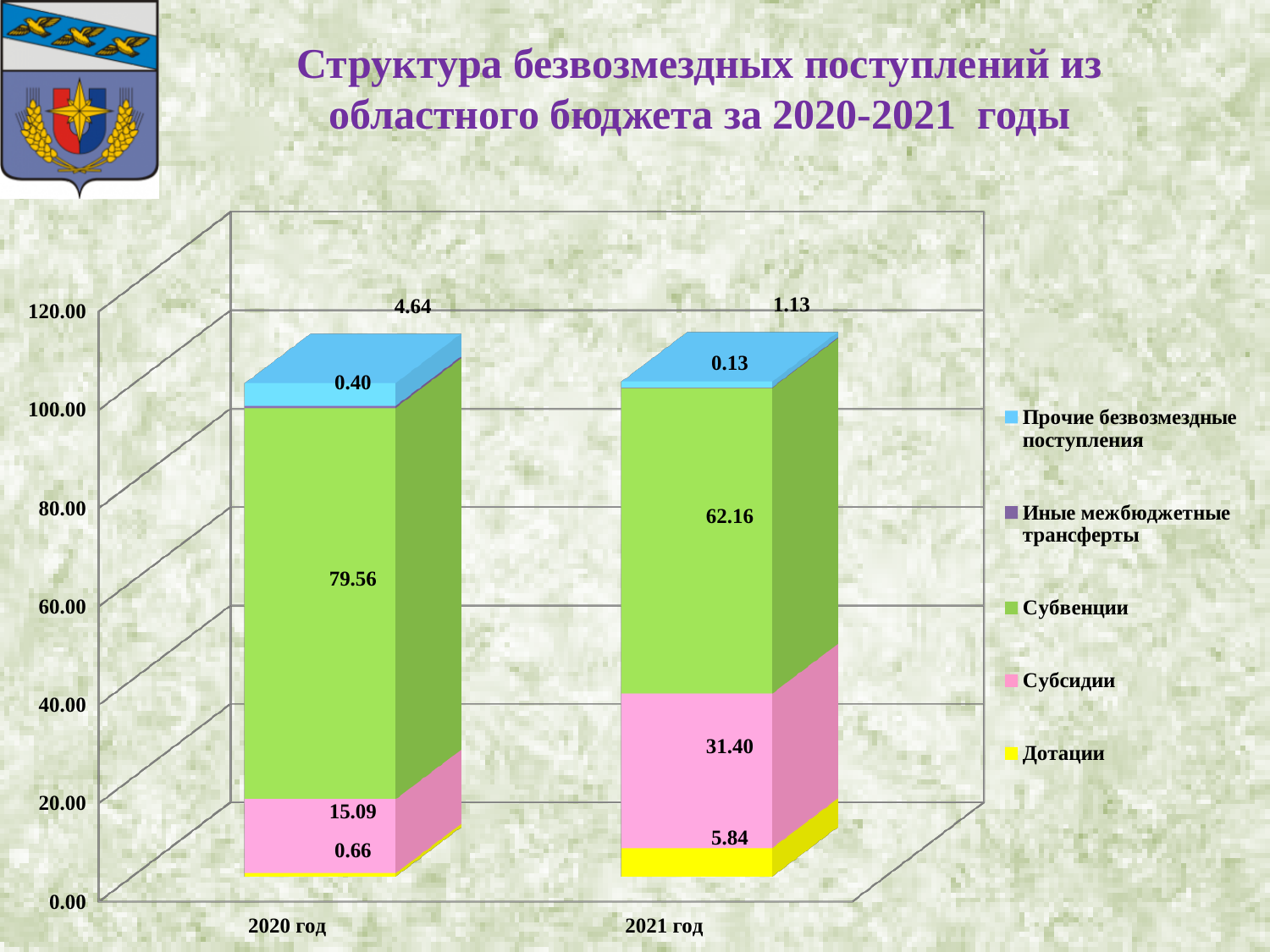
What is the value of Субвенции for 2021 год? 62.16 What is the value of Субвенции for 2020 год? 79.56 What type of chart is shown on the slide? stacked bar chart Which year has the larger value for Дотации, 2020 год or 2021 год? 2021 год What is the value of Дотации for 2020 год? 0.66 How many categories (years) are shown on the x axis? 2 How many series does the legend list? 5 What is the value of Субсидии for 2021 год? 31.40 Which series is shown in green in the legend? Субвенции Does the value of Субвенции rise or fall from 2020 год to 2021 год? fall By how much did Субсидии change from 2020 год to 2021 год? 16.31 What is the value of Субсидии for 2020 год? 15.09